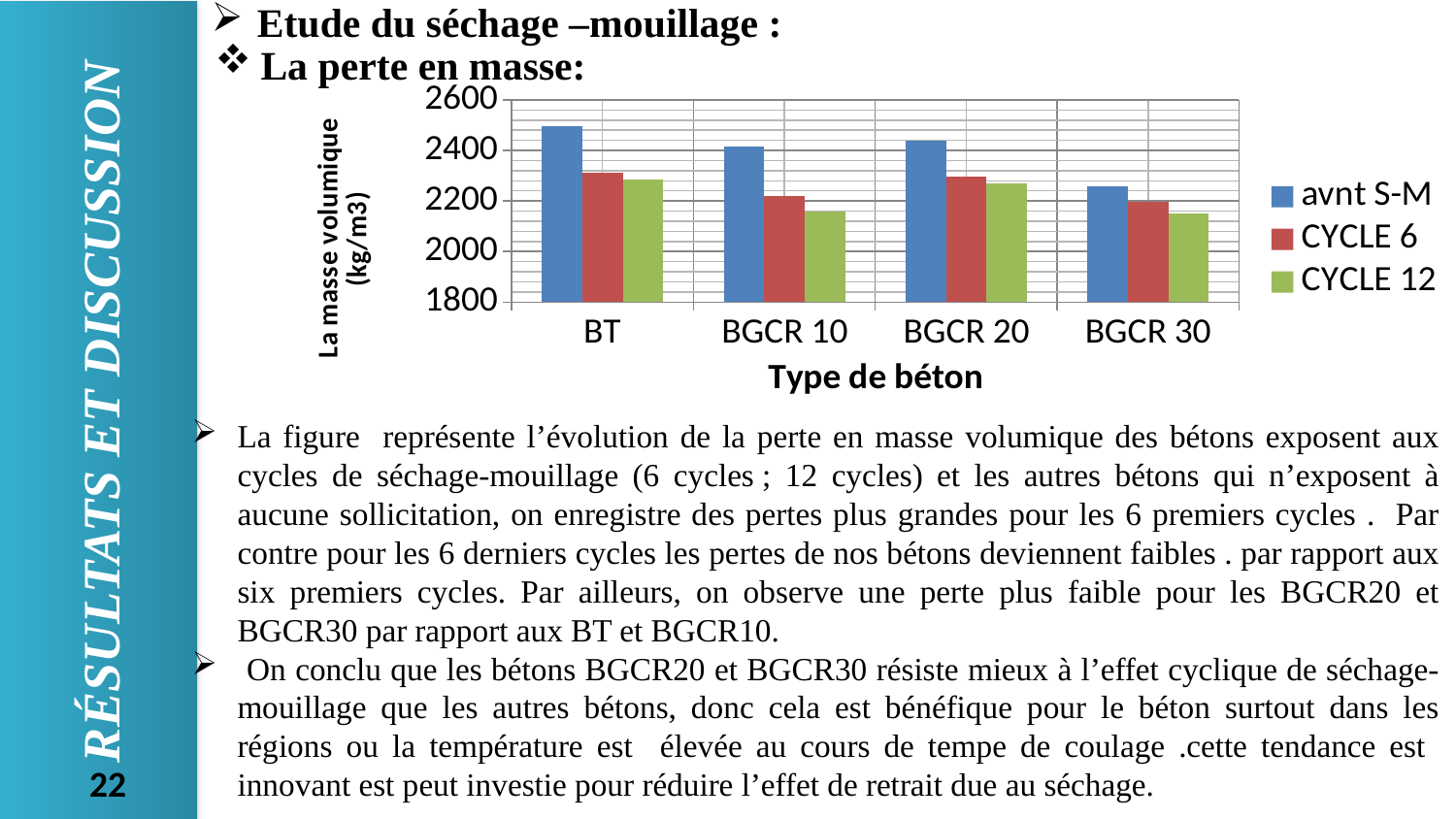
Is the 'CYCLE 12' value for BGCR 10 greater or less than 2200? less Which type of concrete has the lowest 'avnt S-M' value? BGCR 30 Is the 'avnt S-M' value for BT greater or less than 2400? greater Which is larger: the 'avnt S-M' value for BT or the 'avnt S-M' value for BGCR 30? BT What kind of chart is shown on the slide? bar chart How many series does the chart legend list? 3 Is the 'avnt S-M' value for BGCR 30 greater or less than 2400? less Which type of concrete has the highest 'avnt S-M' value? BT Within each type of concrete, do the values rise or fall from 'avnt S-M' to 'CYCLE 6' to 'CYCLE 12'? fall What is the title of the x axis of the chart? Type de béton How many types of concrete (categories) are shown on the x axis of the chart? 4